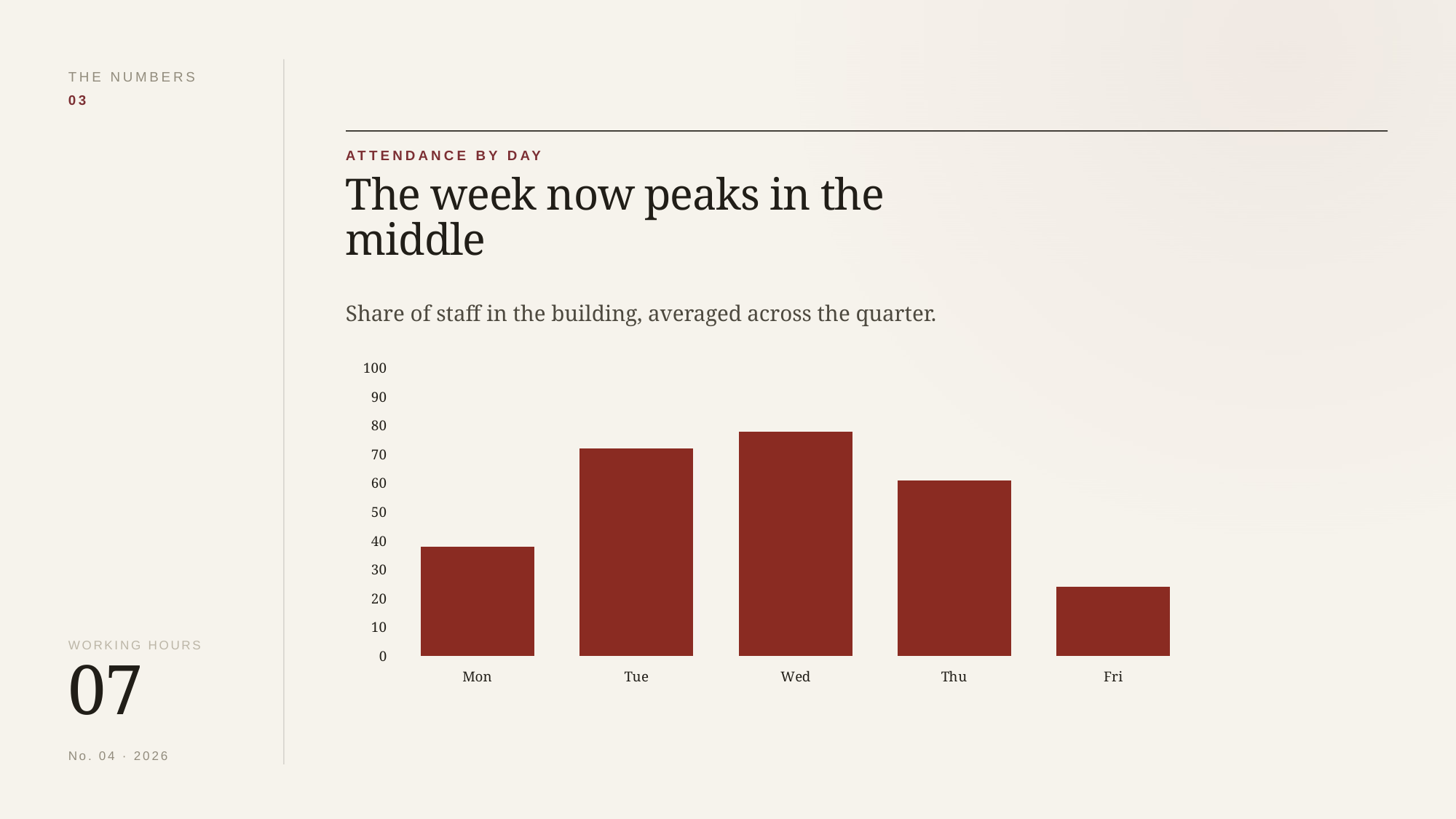
Which day has the lowest share of staff in the building? Fri Is the value for Mon greater or less than 30? greater Is the value for Wed greater or less than 70? greater Do the values rise or fall from Wed to Fri? fall How many days are shown on the x axis of the chart? 5 Is the value for Tue greater or less than 80? less What kind of chart is shown on the slide? bar chart Which is larger, the value for Tue or the value for Thu? Tue Which day has the highest share of staff in the building? Wed What is the section label printed above the slide's headline? ATTENDANCE BY DAY